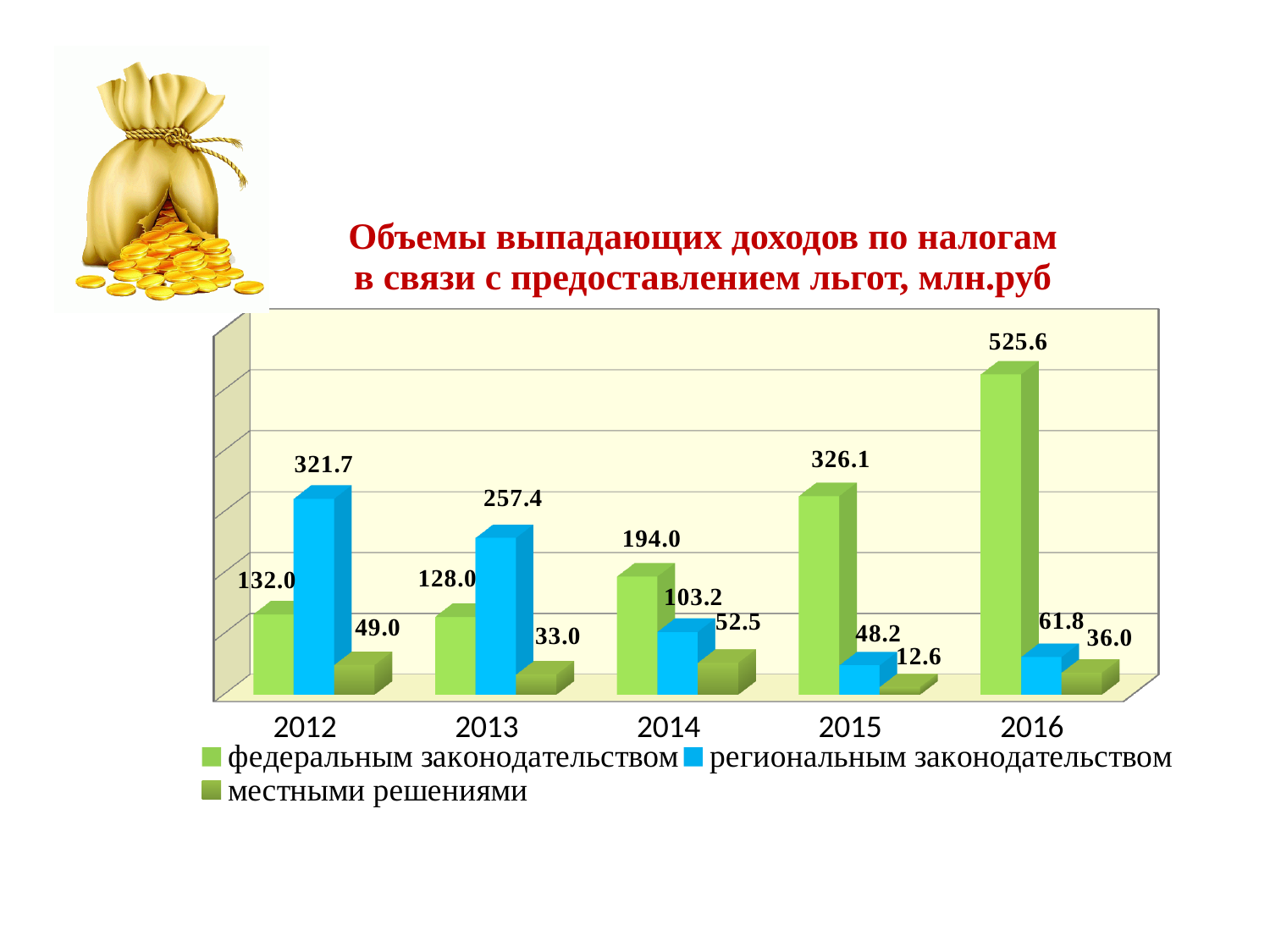
What is the value for "региональным законодательством" in 2012? 321.7 How many series does the legend list? 3 What is the value for "федеральным законодательством" in 2016? 525.6 In which year is the value for "федеральным законодательством" highest? 2016 Does the value for "региональным законодательством" rise or fall from 2012 to 2015? fall Which is larger in 2013: the value for "федеральным законодательством" or for "региональным законодательством"? региональным законодательством What is the value for "местными решениями" in 2015? 12.6 What is the difference between the "федеральным законодательством" values for 2016 and 2015? 199.5 What kind of chart is shown on the slide? bar chart How many years are shown on the x axis? 5 In which year is the value for "местными решениями" lowest? 2015 What is the value for "региональным законодательством" in 2014? 103.2